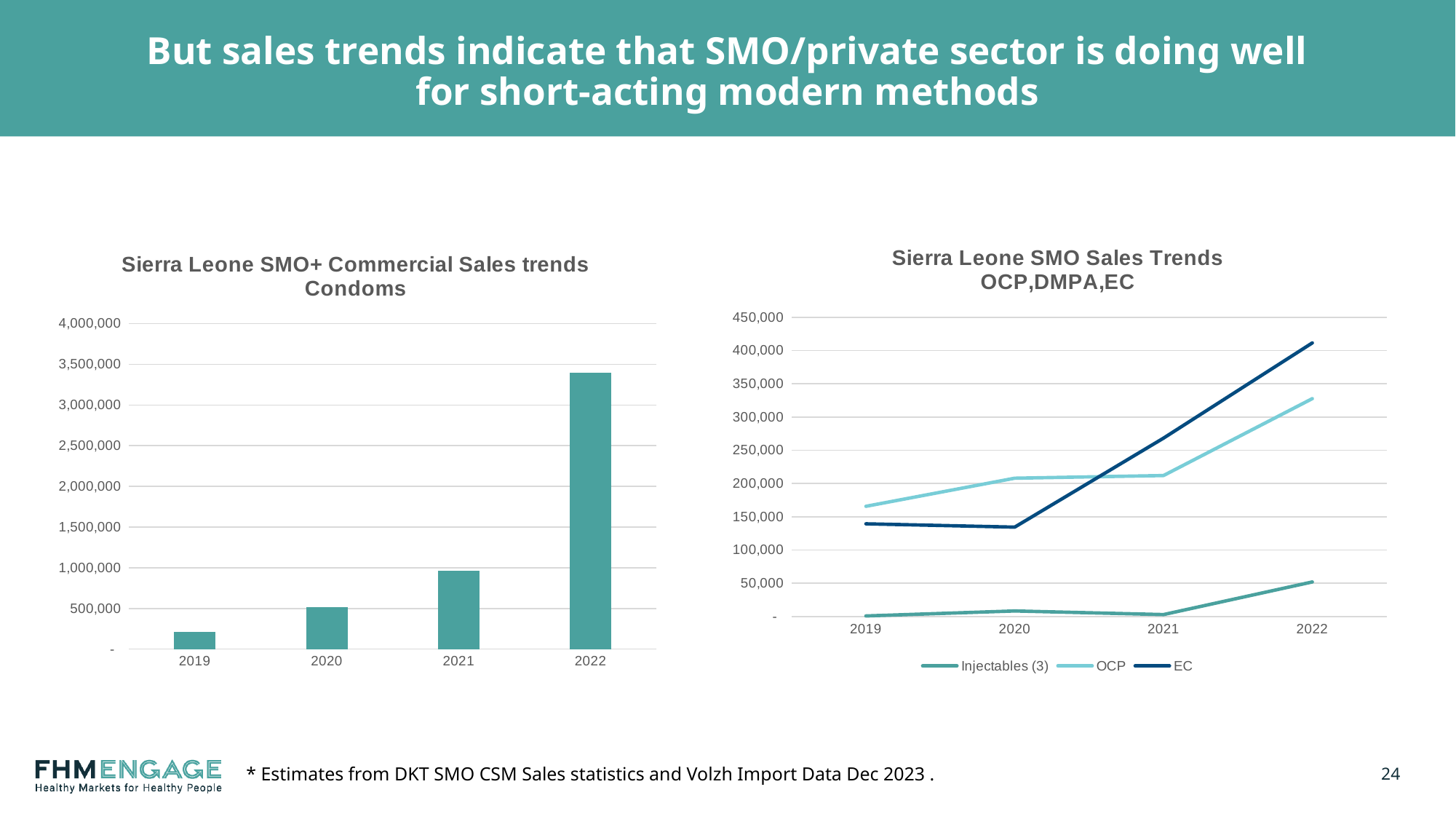
In the left chart (Condoms), is the value for 2022 greater or less than 3,000,000? greater What kind of chart is the right chart titled "Sierra Leone SMO Sales Trends OCP,DMPA,EC"? line chart In the left chart (Condoms), which year has the lowest bar? 2019 What kind of chart is the left chart titled "Sierra Leone SMO+ Commercial Sales trends Condoms"? bar chart In the left chart (Condoms), how many years are shown on the x axis? 4 In the left chart (Condoms), which year has the highest bar? 2022 In the right chart (OCP,DMPA,EC), which series has the highest value in 2022? EC In the right chart (OCP,DMPA,EC), how many series does the legend list? 3 In the right chart (OCP,DMPA,EC), which is larger in 2019, OCP or EC? OCP In the left chart (Condoms), is the value for 2019 greater or less than 500,000? less In the right chart (OCP,DMPA,EC), is the value for OCP in 2022 greater or less than 300,000? greater In the left chart (Condoms), do the values rise or fall from 2019 to 2022? rise